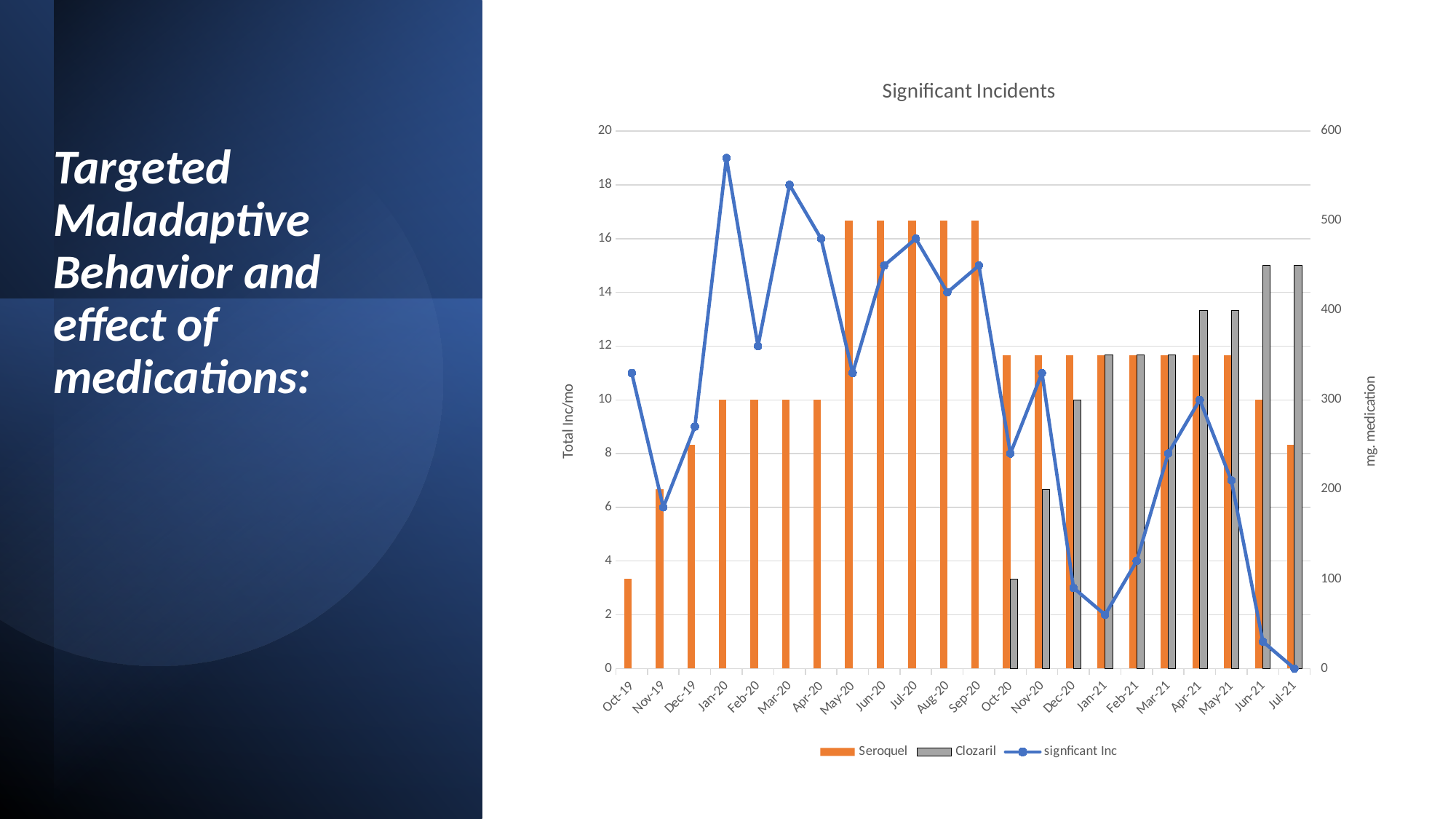
What is the title of the chart? Significant Incidents Does the signficant Inc line generally rise or fall from Apr-21 to Jul-21? fall How many series does the legend list? 3 What kind of chart is shown? Combination bar and line chart In which month does the signficant Inc line reach its lowest point? Jul-21 What is the signficant Inc value for Jul-21? 0 How many months are shown on the x axis? 22 In which month is the Seroquel bar lowest? Oct-19 Is the signficant Inc value for Jan-20 greater or less than 18? greater Which is larger in Jun-21, the Seroquel bar or the Clozaril bar? Clozaril In which month does the signficant Inc line reach its highest point? Jan-20 Is the Seroquel value for May-20 greater or less than 400 mg? greater